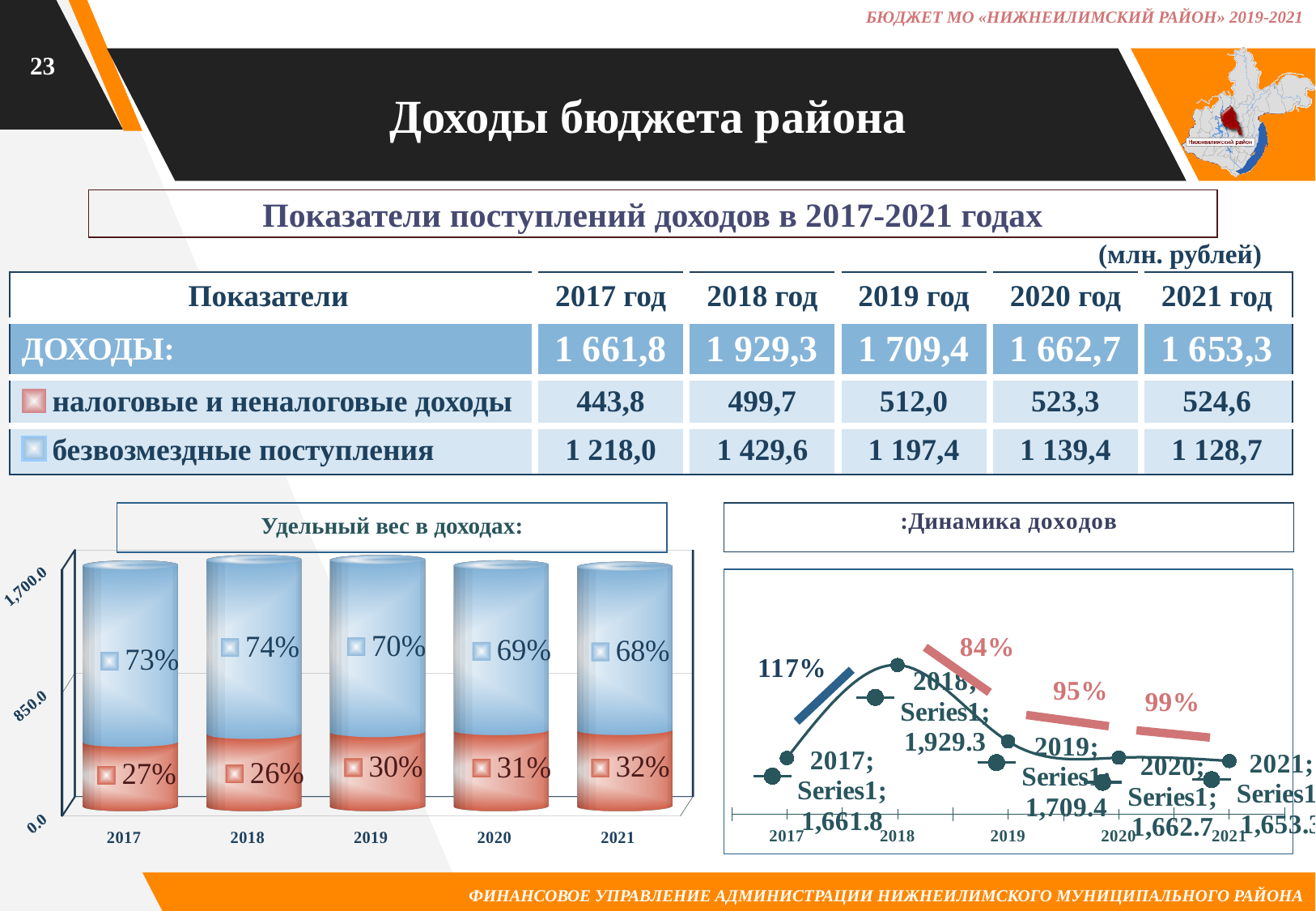
In the 'Удельный вес в доходах:' chart, what is the difference between the blue and red shares in 2017? 46% In the 'Динамика доходов' chart, which year has the highest value? 2018 What kind of chart is the 'Динамика доходов' chart on the right? line chart In the 'Динамика доходов' chart, what is the value for 2018? 1,929.3 In the 'Динамика доходов' chart, do the values rise or fall from 2018 to 2021? fall In the 'Удельный вес в доходах:' chart, how many years are shown along the x axis? 5 What kind of chart is the 'Удельный вес в доходах:' chart on the left? bar chart In the 'Удельный вес в доходах:' chart, which year has the lowest blue (upper) share? 2021 In the 'Удельный вес в доходах:' chart, what is the blue (upper) share for 2019? 70% In the 'Удельный вес в доходах:' chart, which year has the highest red (lower) share? 2021 In the 'Удельный вес в доходах:' chart, what is the total of the two segments for 2018? 100% In the 'Удельный вес в доходах:' chart, what is the red (lower) share for 2021? 32%